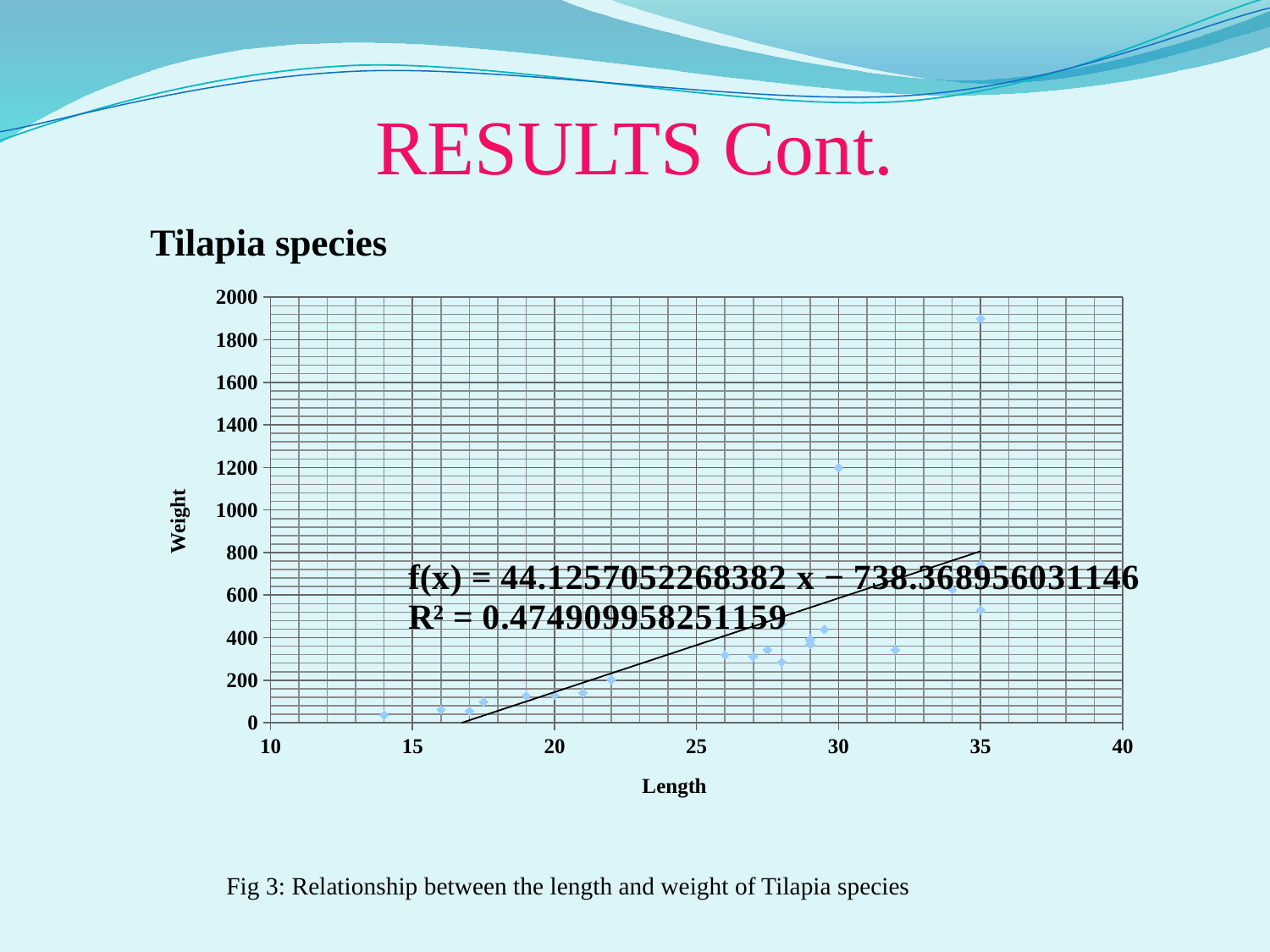
What is the slope of the fitted line f(x) printed on the chart? 44.1257052268382 What kind of chart is shown on the slide? Scatter chart Which of the two points, the one at length 30 or the one at length 35 with the highest weight, has the larger weight? The point at length 35 What is the maximum value shown on the y axis of the chart? 2000 Does weight generally rise or fall as length increases along the x axis? Rise What R² value is printed on the chart? 0.474909958251159 What is the title of the chart's x axis? Length Is the weight of the point at length 30 greater or less than 1000? greater What is the title of the chart's y axis? Weight Is the weight of the highest point on the chart greater or less than 1800? greater What is the intercept of the fitted line f(x) printed on the chart? −738.368956031146 Is the weight of the point at length 14 greater or less than 200? less